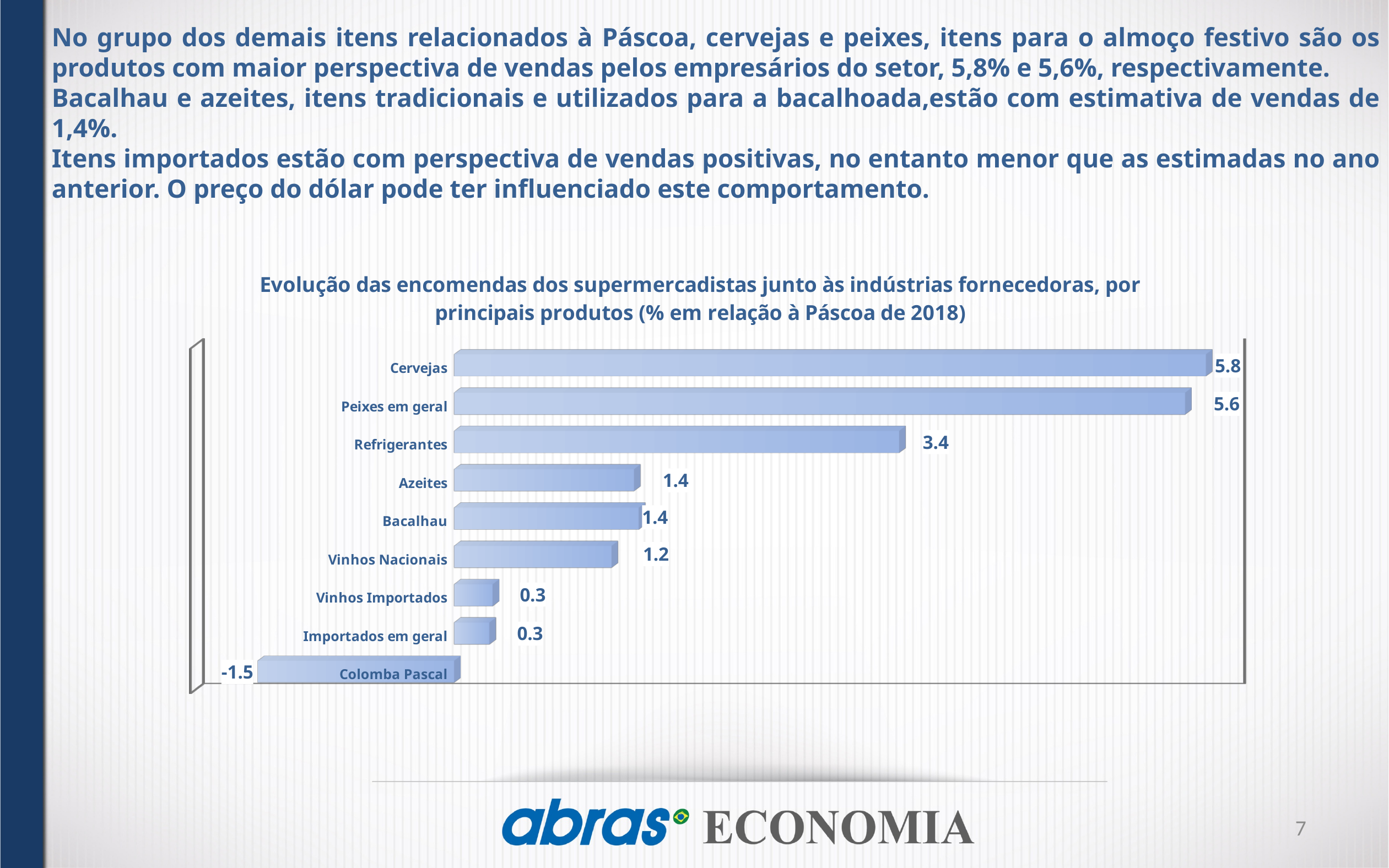
Which category has the highest value? Cervejas What is the difference between the values for Refrigerantes and Azeites? 2.0 Which category has the lowest value? Colomba Pascal Which is larger, the value for Peixes em geral or the value for Refrigerantes? Peixes em geral How many categories are shown in the chart? 9 What is the difference between the values for Cervejas and Peixes em geral? 0.2 What is the value for Cervejas? 5.8 What is the value for Refrigerantes? 3.4 What is the value for Vinhos Nacionais? 1.2 What is the value for Colomba Pascal? -1.5 What kind of chart is shown on the slide? Bar chart What is the title of the chart? Evolução das encomendas dos supermercadistas junto às indústrias fornecedoras, por principais produtos (% em relação à Páscoa de 2018)